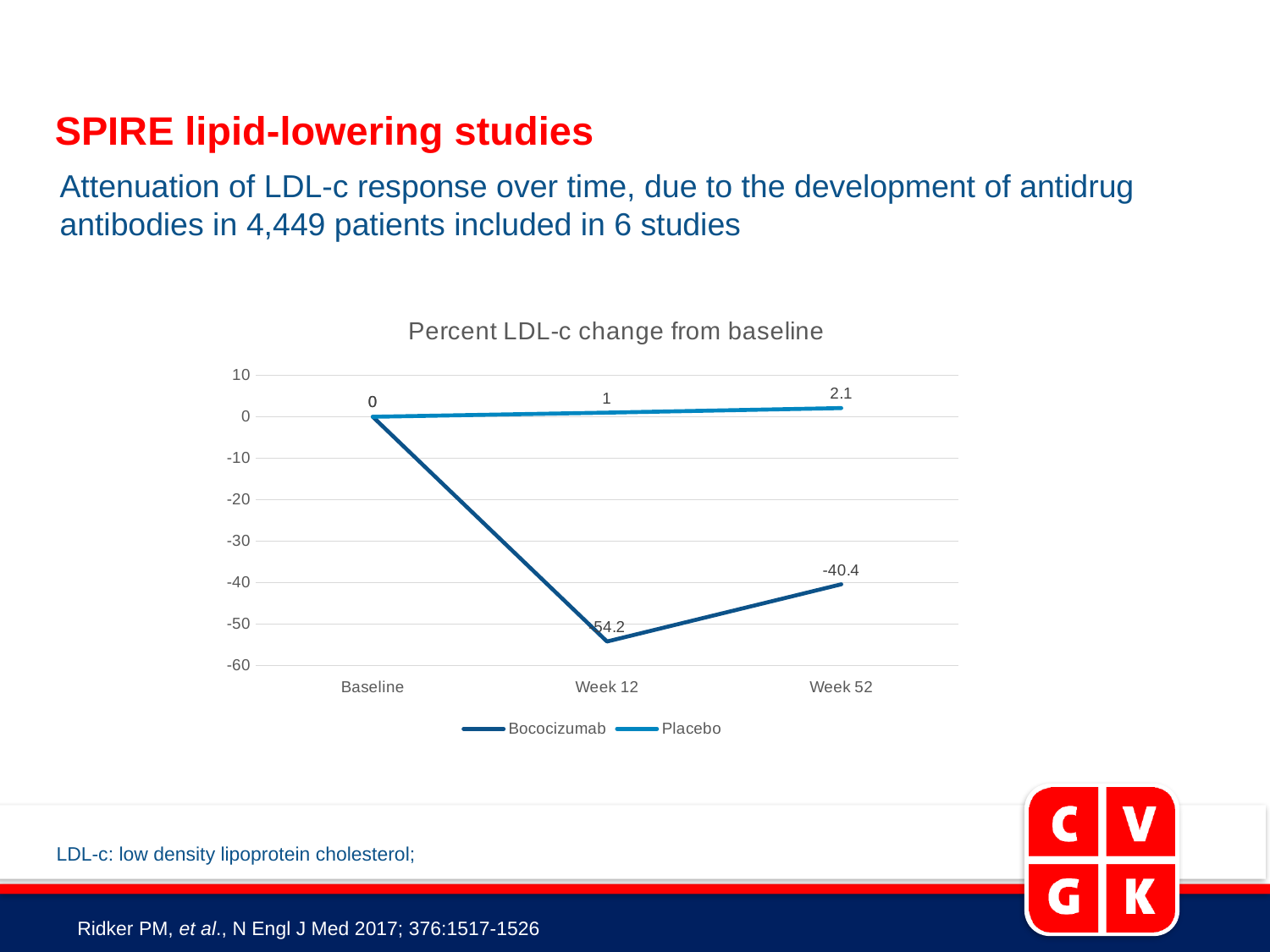
At which time point is the Bococizumab value lowest? Week 12 What is the value for Placebo at Week 52? 2.1 What is the title of the chart? Percent LDL-c change from baseline Does the Placebo line rise or fall from Baseline to Week 52? Rise How many time points are shown on the x axis? 3 What is the value for Bococizumab at Week 12? -54.2 How many series does the legend list? 2 What is the value for Placebo at Week 12? 1 What is the difference between the Bococizumab values at Week 52 and Week 12? 13.8 What is the value for Bococizumab at Week 52? -40.4 What type of chart is shown on the slide? Line chart Which series has the higher value at Week 52, Bococizumab or Placebo? Placebo